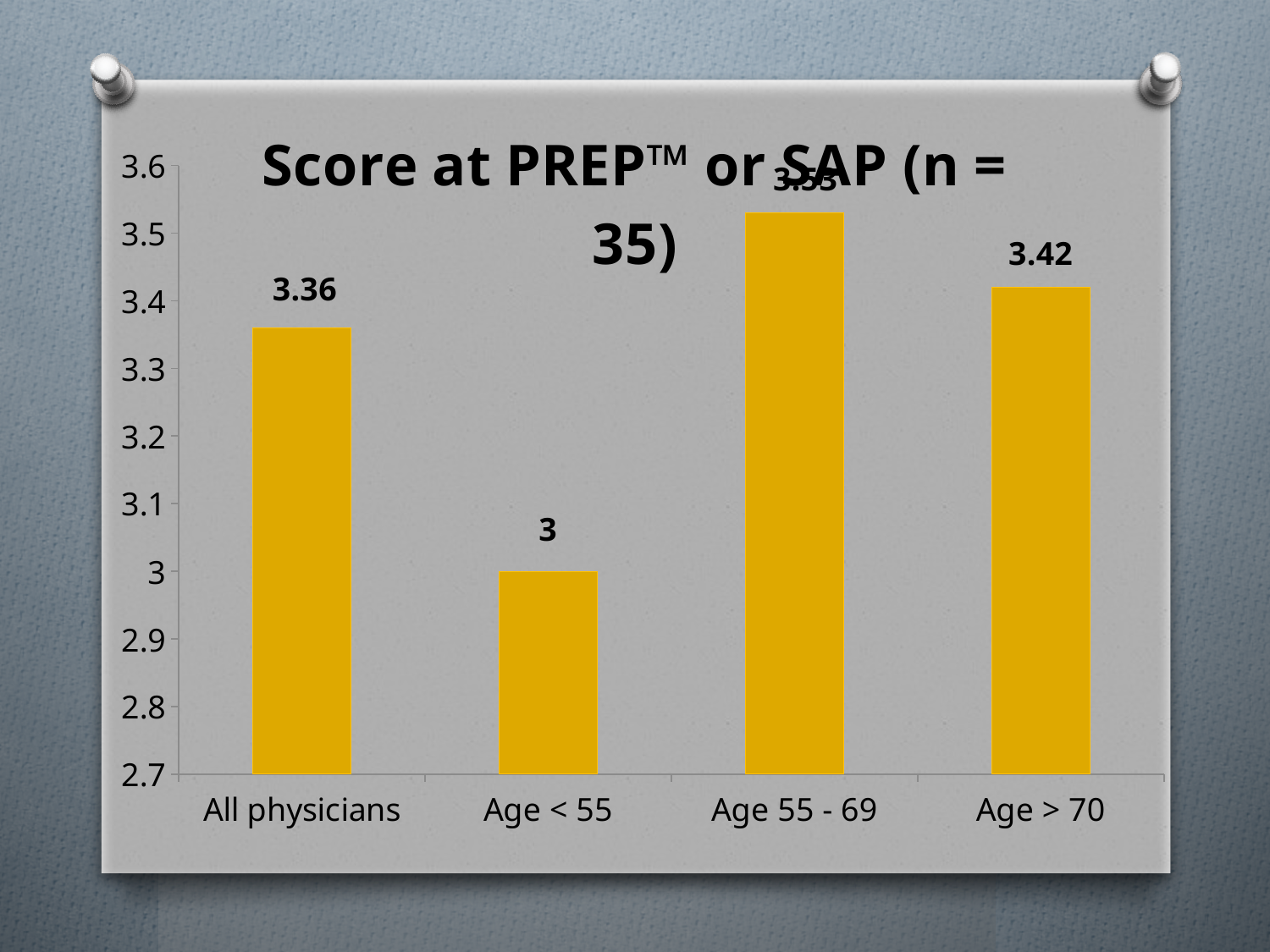
What is the difference between the scores for Age > 70 and All physicians? 0.06 Which category has the highest score? Age 55 - 69 How many categories are shown on the x axis? 4 Which category has the lowest score? Age < 55 What is the title of the chart? Score at PREP™ or SAP (n = 35) Is the value for Age 55 - 69 greater or less than 3.5? greater What kind of chart is shown on the slide? Bar chart What is the difference between the scores for All physicians and Age < 55? 0.36 What is the score for Age < 55? 3 What is the score for All physicians? 3.36 What is the score for Age > 70? 3.42 Which is larger, the score for Age > 70 or the score for All physicians? Age > 70